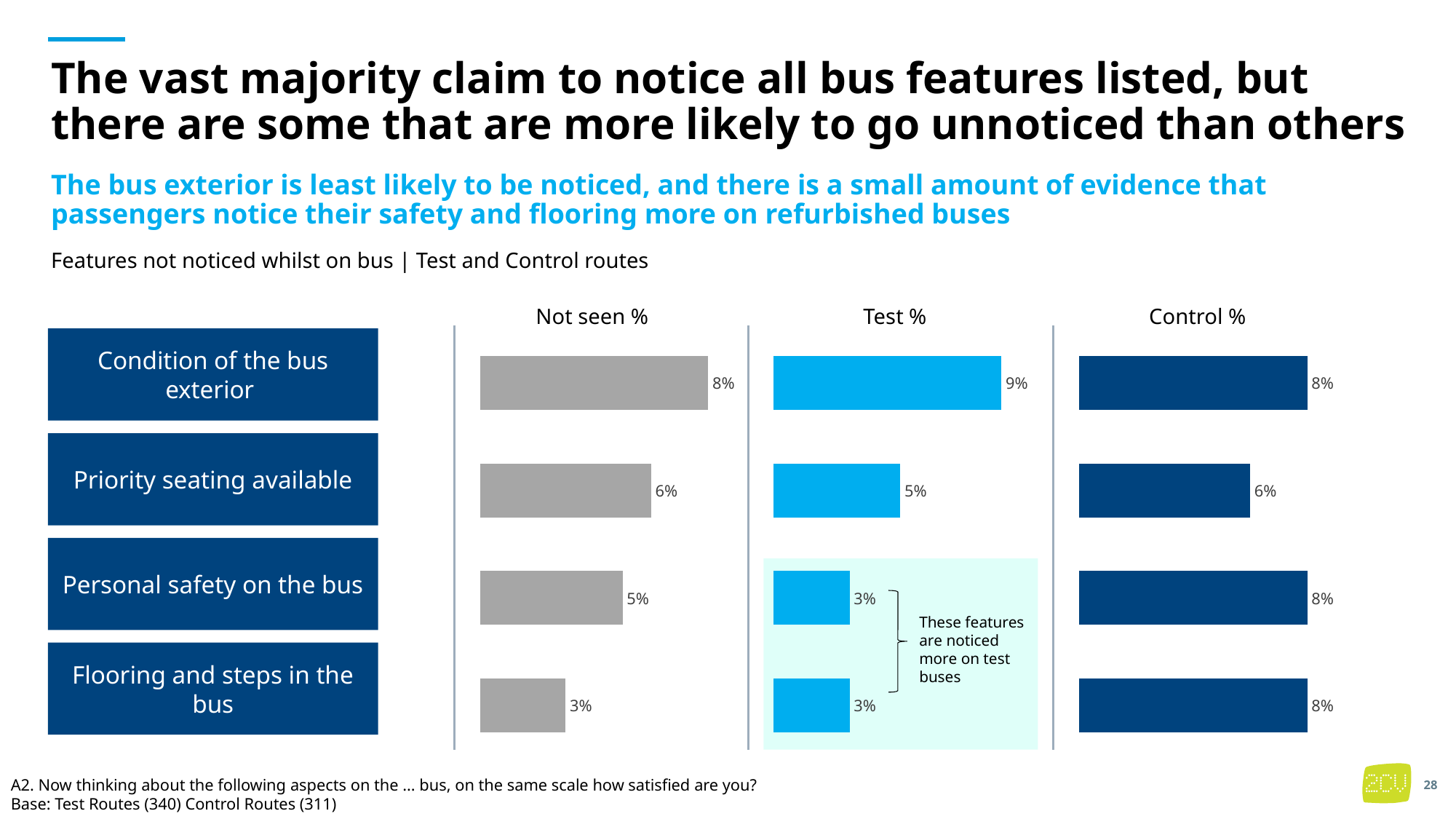
For Flooring and steps in the bus, which is larger: the Test % value or the Control % value? Control % In the Not seen % chart, what is the value for Condition of the bus exterior? 8% What is the difference between the Control % and Test % values for Personal safety on the bus? 5% In the Not seen % chart, what is the difference between Condition of the bus exterior and Flooring and steps in the bus? 5% In the Control % chart, which category has the lowest value? Priority seating available In the Control % chart, what is the value for Personal safety on the bus? 8% What type of chart is used to show the Control % values? Bar chart In the Not seen % chart, which category has the lowest value? Flooring and steps in the bus How many categories are shown in the Test % chart? 4 In the Test % chart, what is the value for Priority seating available? 5% In the Not seen % chart, do the values rise or fall from Condition of the bus exterior down to Flooring and steps in the bus? Fall In the Test % chart, which category has the highest value? Condition of the bus exterior